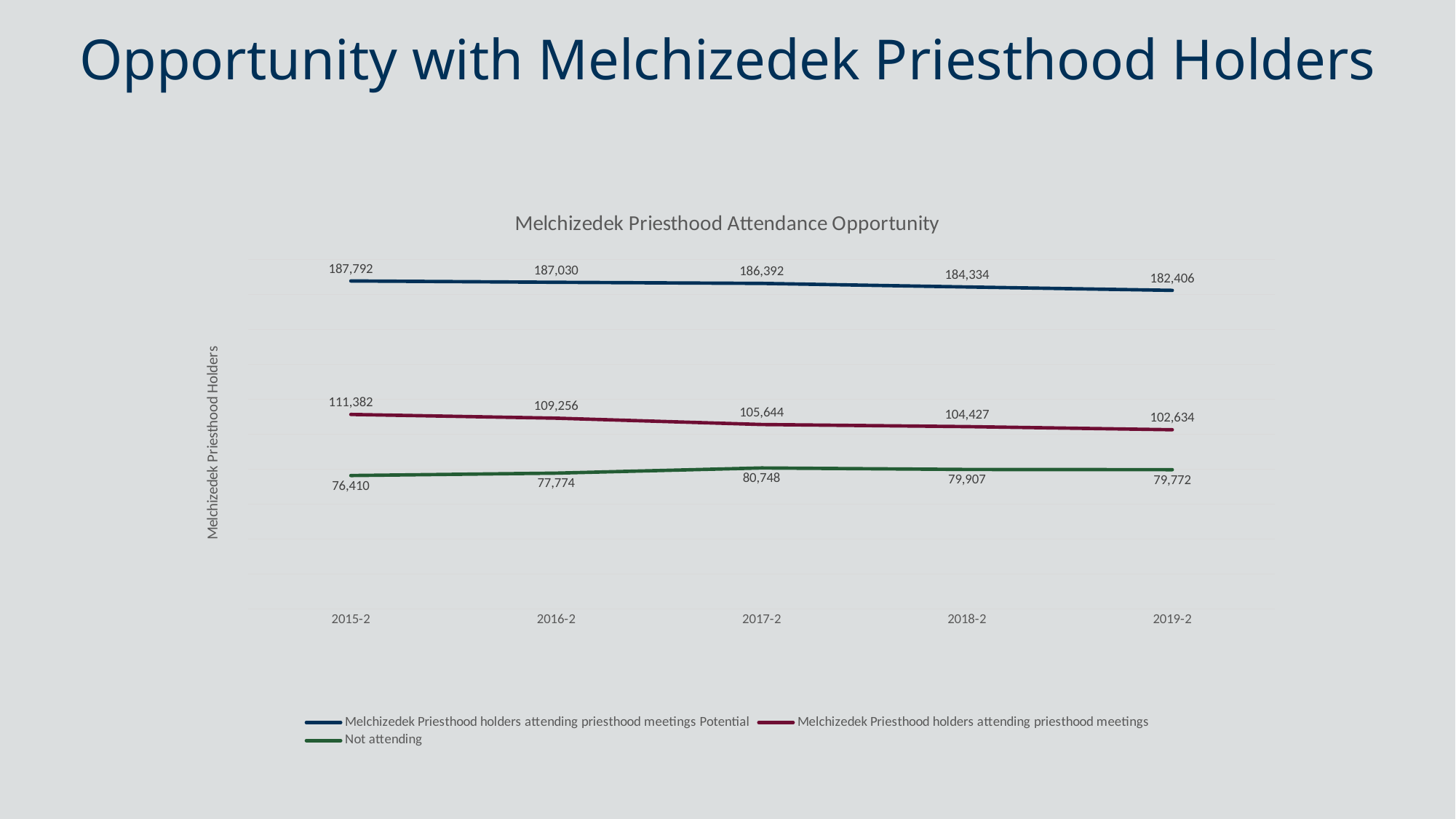
Which is larger in 2018-2: Melchizedek Priesthood holders attending priesthood meetings or Not attending? Melchizedek Priesthood holders attending priesthood meetings What kind of chart is shown? Line chart What is the difference between the Potential value and the attending value in 2019-2? 79,772 In which period is the Not attending series highest? 2017-2 What is the value for Not attending in 2019-2? 79,772 What is the value for Melchizedek Priesthood holders attending priesthood meetings in 2017-2? 105,644 What is the value for Melchizedek Priesthood holders attending priesthood meetings Potential in 2015-2? 187,792 Does the Melchizedek Priesthood holders attending priesthood meetings Potential series rise or fall from 2015-2 to 2019-2? Fall How many periods are shown on the x axis? 5 In which period is the Melchizedek Priesthood holders attending priesthood meetings series lowest? 2019-2 How many series does the legend list? 3 What is the difference between the Not attending values in 2017-2 and 2015-2? 4,338